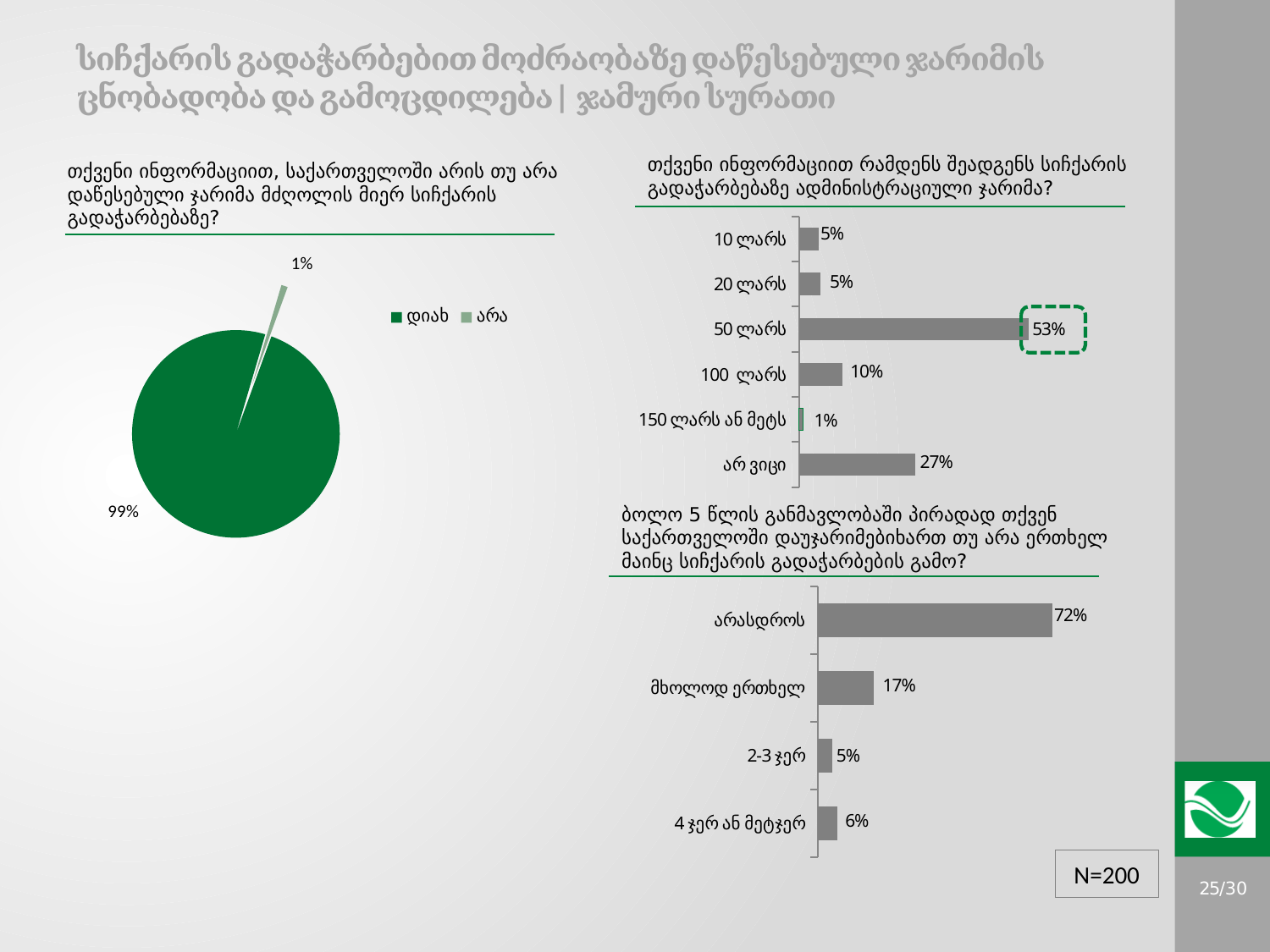
In the top-right bar chart, what is the difference between the values for არ ვიცი and 100 ლარს? 17% In the bottom-right bar chart, what is the value for არასდროს? 72% How many categories does the top-right bar chart show? 6 In the pie chart on the left, what share is labelled for the დიახ slice? 99% In the pie chart on the left, what share is labelled for the არა slice? 1% How many entries does the legend of the pie chart on the left list? 2 In the bottom-right bar chart, which is larger: 2-3 ჯერ or 4 ჯერ ან მეტჯერ? 4 ჯერ ან მეტჯერ What kind of chart is the chart in the top right of the slide? bar chart In the bottom-right bar chart, what is the difference between the values for არასდროს and მხოლოდ ერთხელ? 55% In the top-right bar chart, what is the value for 50 ლარს? 53% In the top-right bar chart, which category has the lowest value? 150 ლარს ან მეტს How many categories does the bottom-right bar chart show? 4